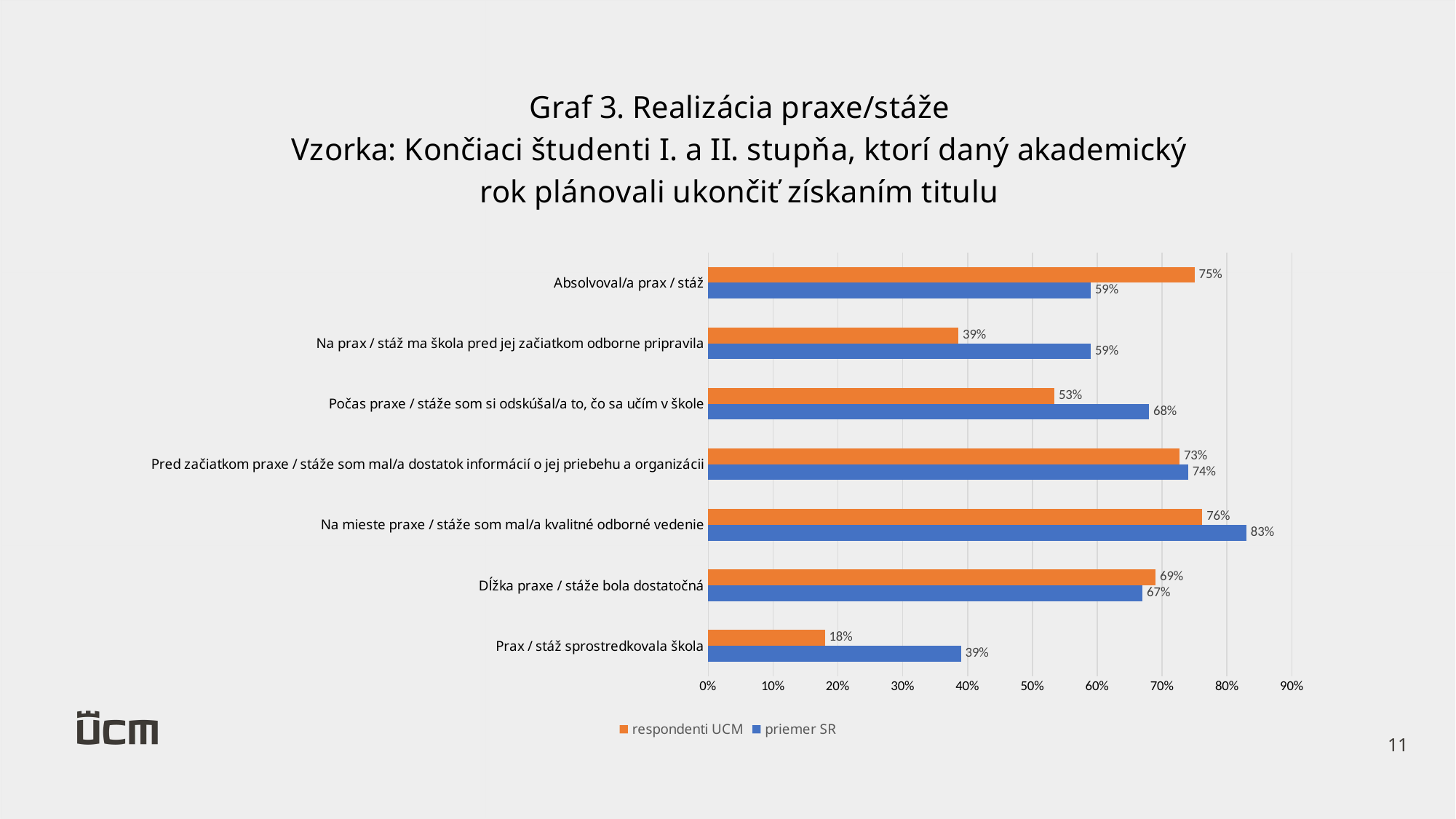
How many categories are shown on the chart? 7 In the category 'Počas praxe / stáže som si odskúšal/a to, čo sa učím v škole', which series has the larger value, 'respondenti UCM' or 'priemer SR'? priemer SR How many series does the legend list? 2 In the category 'Dĺžka praxe / stáže bola dostatočná', which series has the larger value, 'respondenti UCM' or 'priemer SR'? respondenti UCM Which category has the highest value for 'respondenti UCM'? Na mieste praxe / stáže som mal/a kvalitné odborné vedenie What is the value for 'priemer SR' in the category 'Prax / stáž sprostredkovala škola'? 39% What is the value for 'priemer SR' in the category 'Na mieste praxe / stáže som mal/a kvalitné odborné vedenie'? 83% Which category has the lowest value for 'respondenti UCM'? Prax / stáž sprostredkovala škola What is the value for 'respondenti UCM' in the category 'Absolvoval/a prax / stáž'? 75% Which colour represents the series 'priemer SR'? blue What kind of chart is shown on the slide? bar chart What is the difference between 'priemer SR' and 'respondenti UCM' in the category 'Na prax / stáž ma škola pred jej začiatkom odborne pripravila'? 20%